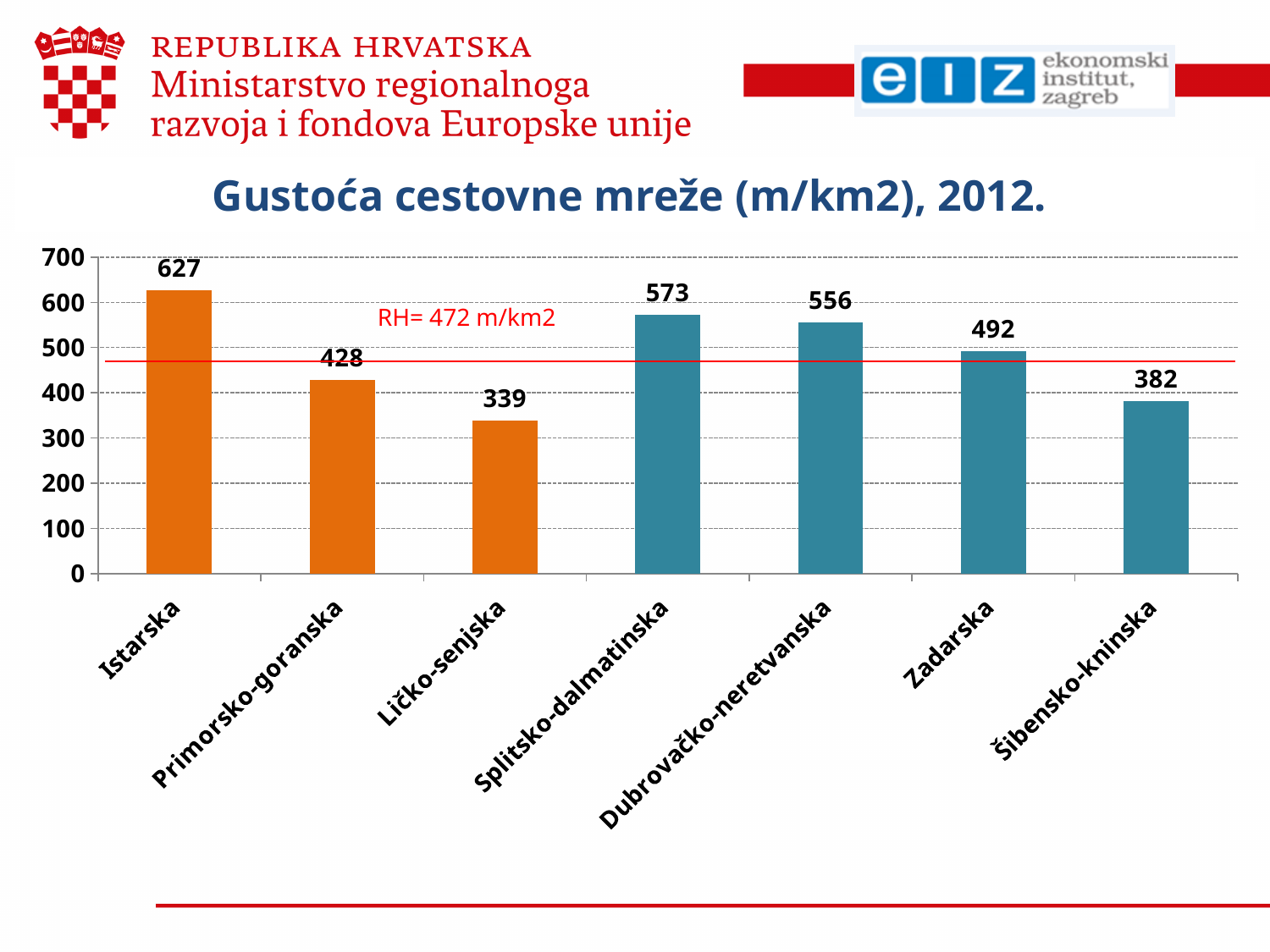
What is the value of the red reference line labelled RH? 472 m/km2 Which is larger, the value for Primorsko-goranska or the value for Šibensko-kninska? Primorsko-goranska What type of chart is shown on the slide? Bar chart What is the road network density value for Istarska? 627 What is the title of the chart? Gustoća cestovne mreže (m/km2), 2012. Which county has the highest road network density? Istarska How many counties are shown on the chart? 7 What is the value shown for Ličko-senjska? 339 What is the value shown for Zadarska? 492 What is the difference between the values for Splitsko-dalmatinska and Dubrovačko-neretvanska? 17 Which county has the lowest road network density? Ličko-senjska What is the difference between the values for Istarska and Ličko-senjska? 288